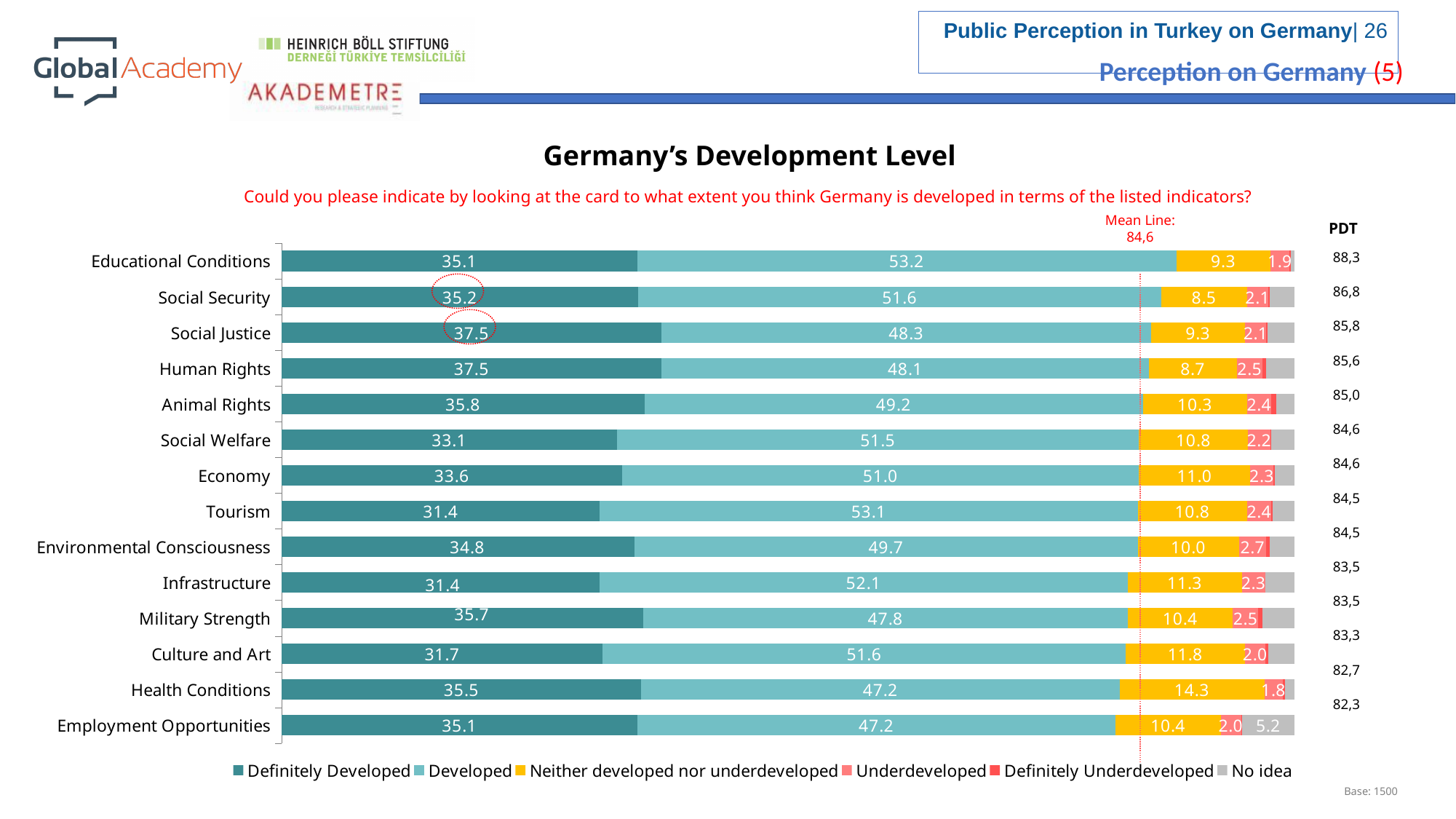
Which indicator has the highest 'Neither developed nor underdeveloped' value? Health Conditions What is the PDT value for Educational Conditions? 88,3 How many series does the legend list? 6 How many indicators are listed in the chart? 14 What is the difference between the 'Definitely Developed' values for Social Justice and Social Welfare? 4.4 What value is shown for the Mean Line? 84,6 What is the 'Developed' value for Educational Conditions? 53.2 Which indicator has the lowest PDT value? Employment Opportunities What is the 'Definitely Developed' value for Social Justice? 37.5 What is the 'Neither developed nor underdeveloped' value for Health Conditions? 14.3 What is the 'No idea' value shown for Employment Opportunities? 5.2 Which has a larger 'Definitely Developed' value, Military Strength or Economy? Military Strength